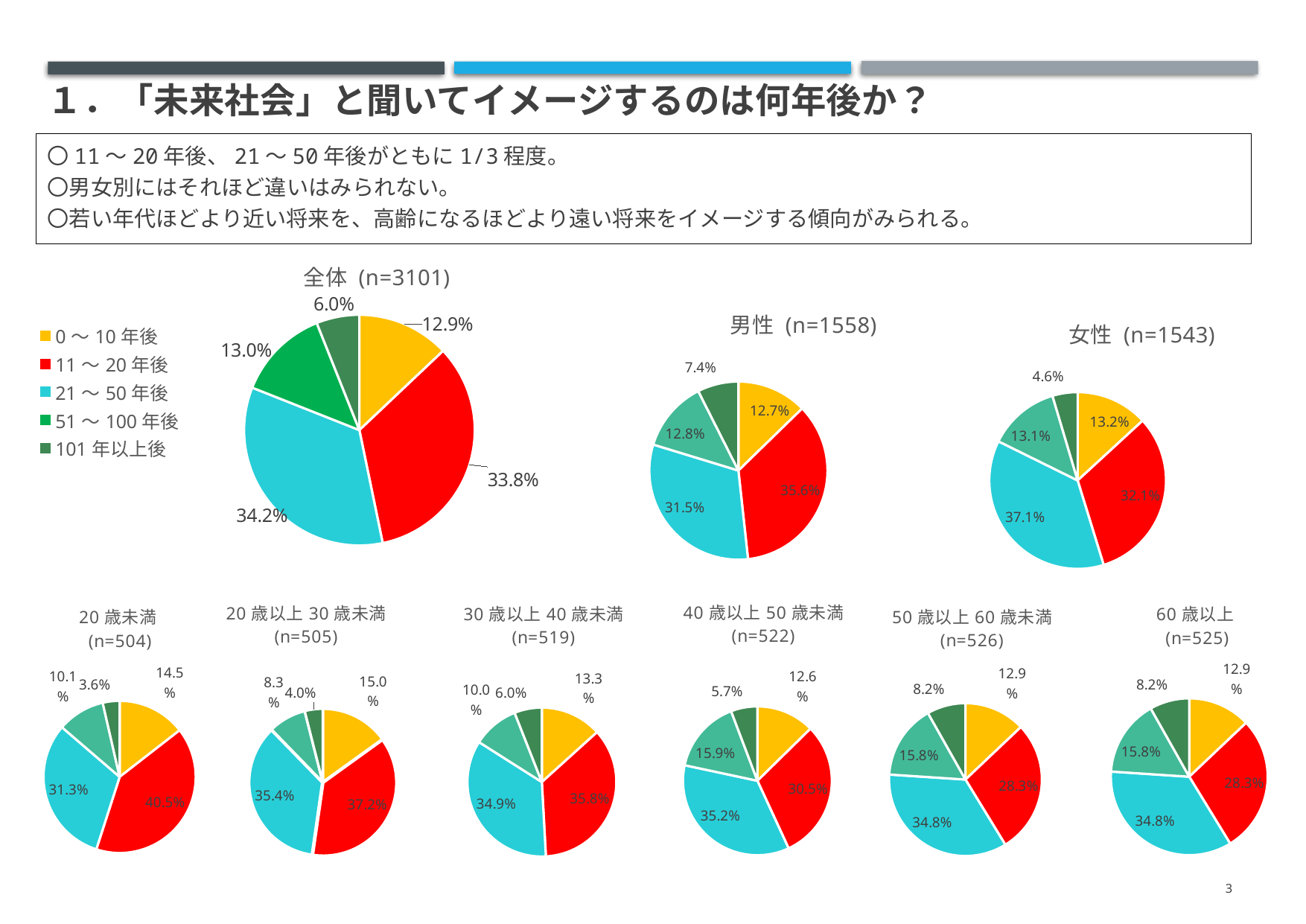
In the 全体 (n=3101) chart, what share is labelled for 11～20年後? 33.8% How many pie charts are shown on the slide? 9 What kind of chart is used for the 全体 (n=3101) chart? pie chart In the 女性 (n=1543) chart, which category has the largest share? 21～50年後 In the 全体 (n=3101) chart, which category has the smallest share? 101年以上後 In the 40歳以上50歳未満 (n=522) chart, what is the share for 51～100年後? 15.9% How many entries does the legend list? 5 In the 男性 (n=1558) chart, what is the share for 21～50年後? 31.5% Which is larger: the 11～20年後 share in the 20歳未満 (n=504) chart or in the 60歳以上 (n=525) chart? 20歳未満 (n=504) In the 30歳以上40歳未満 (n=519) chart, what is the share for 101年以上後? 6.0% In the 女性 (n=1543) chart, what is the difference between the 21～50年後 share and the 11～20年後 share? 5.0% In the 20歳未満 (n=504) chart, what is the share for 11～20年後? 40.5%